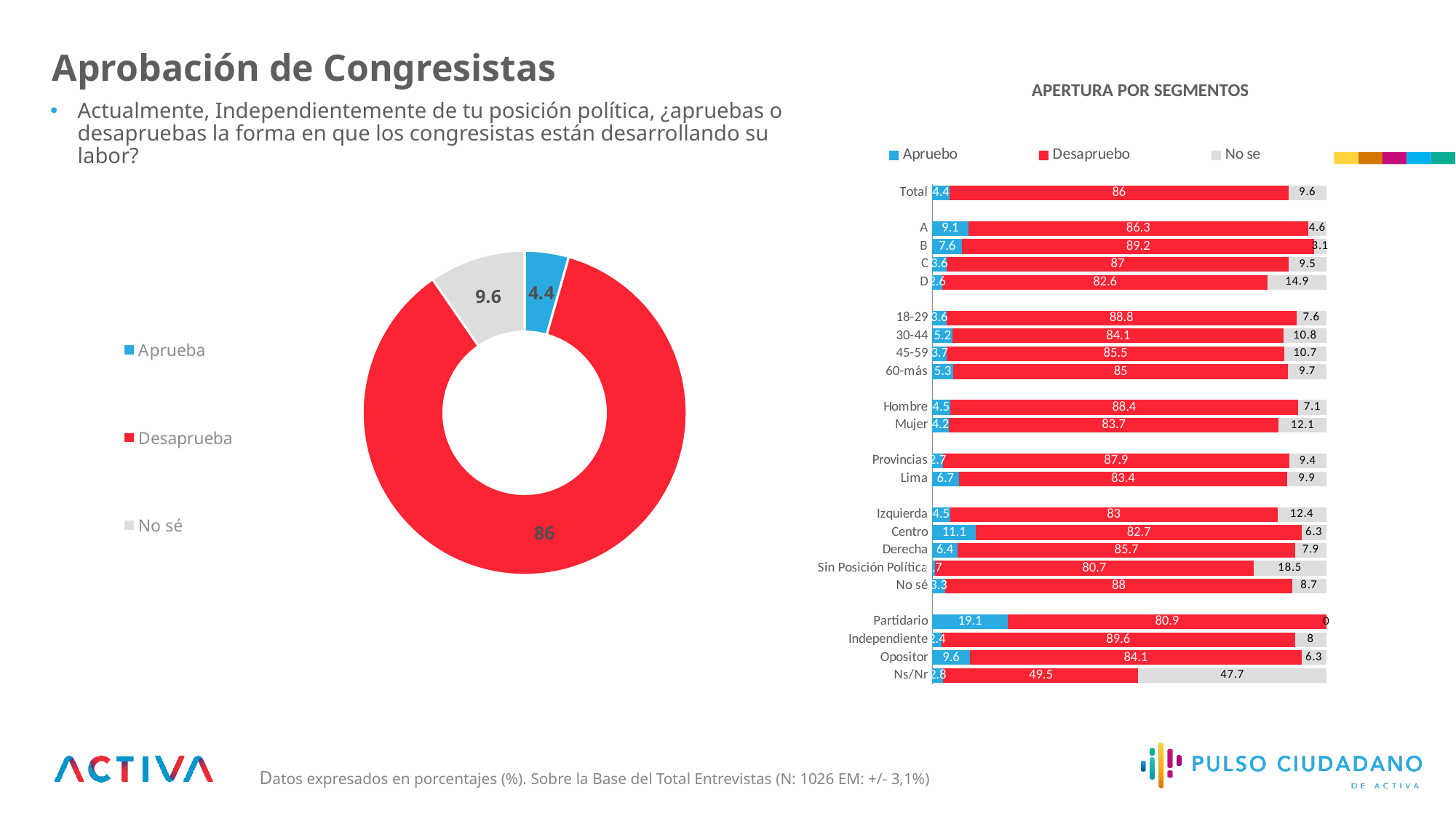
What kind of chart is the 'APERTURA POR SEGMENTOS' chart on the right? Bar chart In the 'APERTURA POR SEGMENTOS' chart, what is the No se value for Ns/Nr? 47.7 In the 'APERTURA POR SEGMENTOS' chart, which segment has the lowest Desapruebo value? Ns/Nr In the donut chart on the left, how many categories does the legend list? 3 In the donut chart on the left, which category has the smallest share? Aprueba In the donut chart on the left, what is the value for Desaprueba? 86 In the donut chart on the left, what is the value for Aprueba? 4.4 In the 'APERTURA POR SEGMENTOS' chart, what is the Apruebo value for Partidario? 19.1 In the 'APERTURA POR SEGMENTOS' chart, how many series does the legend list? 3 What kind of chart is the chart on the left of the slide? Pie chart (donut) In the 'APERTURA POR SEGMENTOS' chart, which has the larger Apruebo value, Lima or Centro? Centro In the 'APERTURA POR SEGMENTOS' chart, what is the difference between the Desapruebo values for B and Izquierda? 6.2